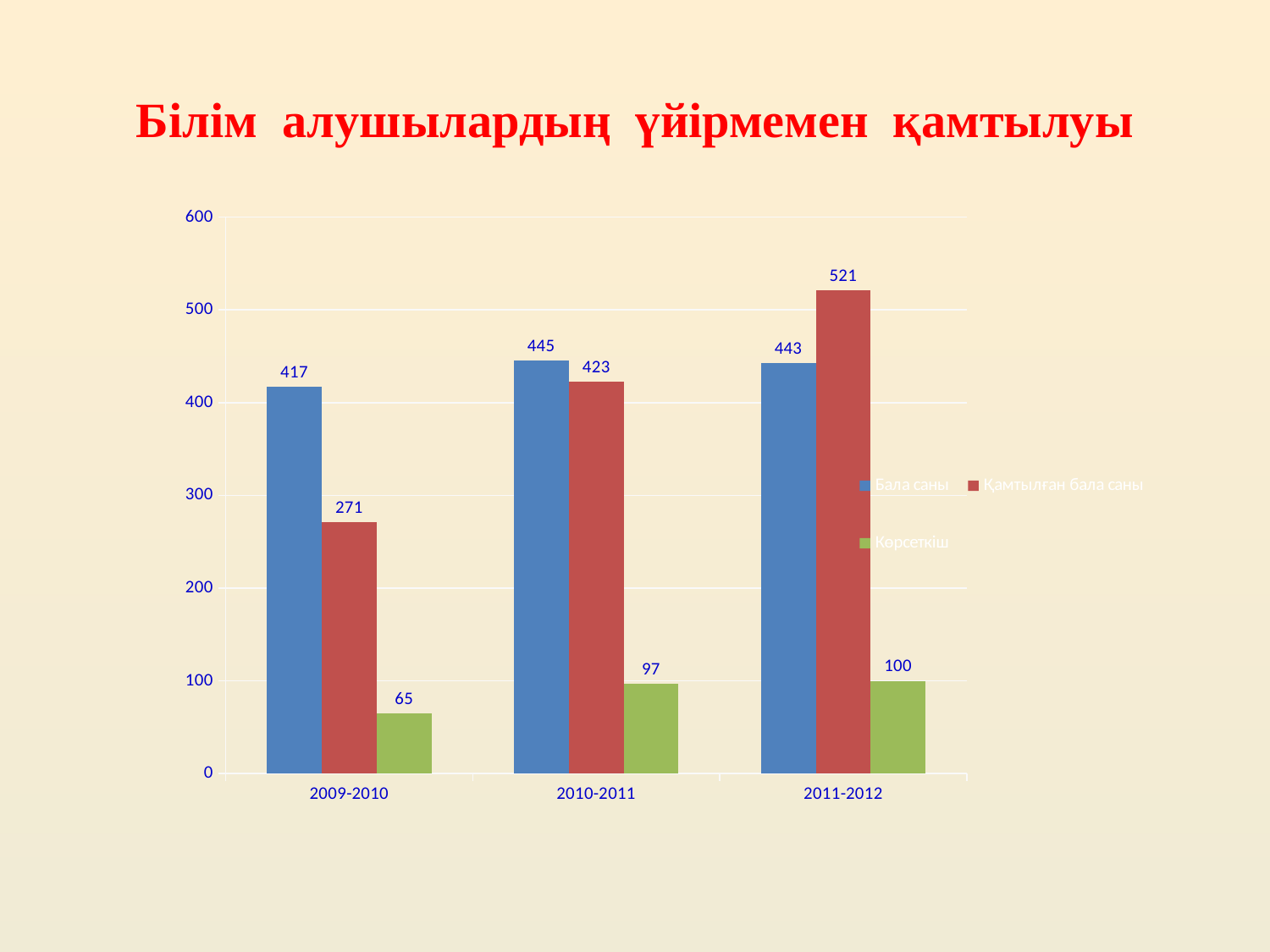
In which year is Қамтылған бала саны the highest? 2011-2012 What kind of chart is shown on the slide? bar chart Which is larger in 2011-2012, Бала саны or Қамтылған бала саны? Қамтылған бала саны What is the value of Қамтылған бала саны for 2011-2012? 521 How many year categories are shown on the x axis? 3 What is the value of Бала саны for 2009-2010? 417 Does Қамтылған бала саны rise or fall from 2009-2010 to 2011-2012? rise In which year is Көрсеткіш the lowest? 2009-2010 Is the value of Қамтылған бала саны for 2010-2011 greater or less than 400? greater What is the difference between Бала саны and Қамтылған бала саны in 2009-2010? 146 What is the value of Көрсеткіш for 2010-2011? 97 How many series does the legend list? 3